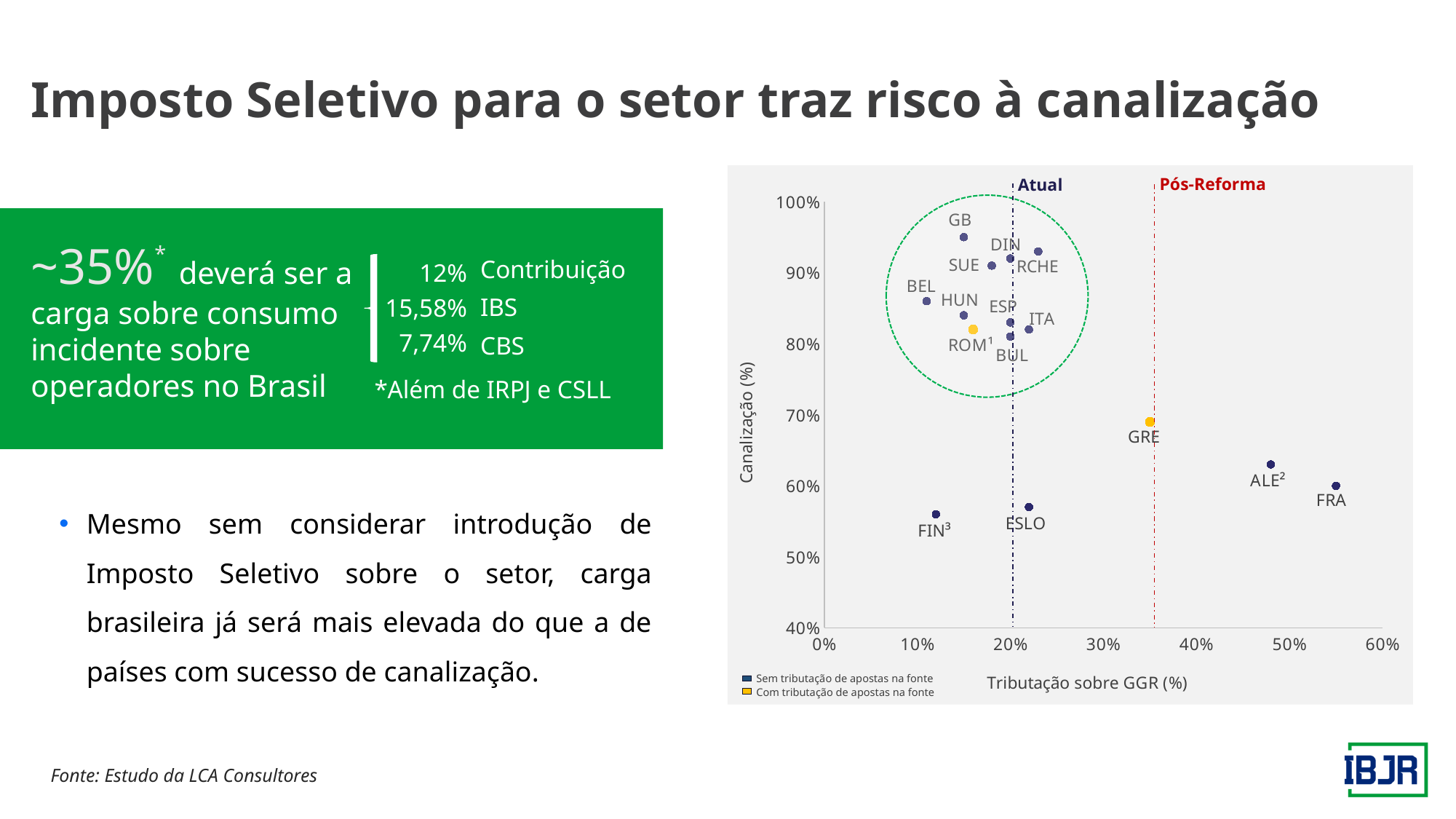
Which two countries are plotted with the 'Com tributação de apostas na fonte' marker? ROM¹ and GRE Is the Canalização value for GRE greater or less than 60%? greater What kind of chart is shown on the slide? scatter chart What is the label of the x axis of the chart? Tributação sobre GGR (%) How many series does the chart legend list? 2 Is the Canalização value for FIN³ greater or less than 60%? less Which country has the highest Canalização (%) on the chart? GB Which country has the highest Tributação sobre GGR (%) on the chart? FRA How many countries are plotted as points on the chart? 15 Is the Canalização value for GB greater or less than 90%? greater Which has a higher Canalização value, GRE or FRA? GRE